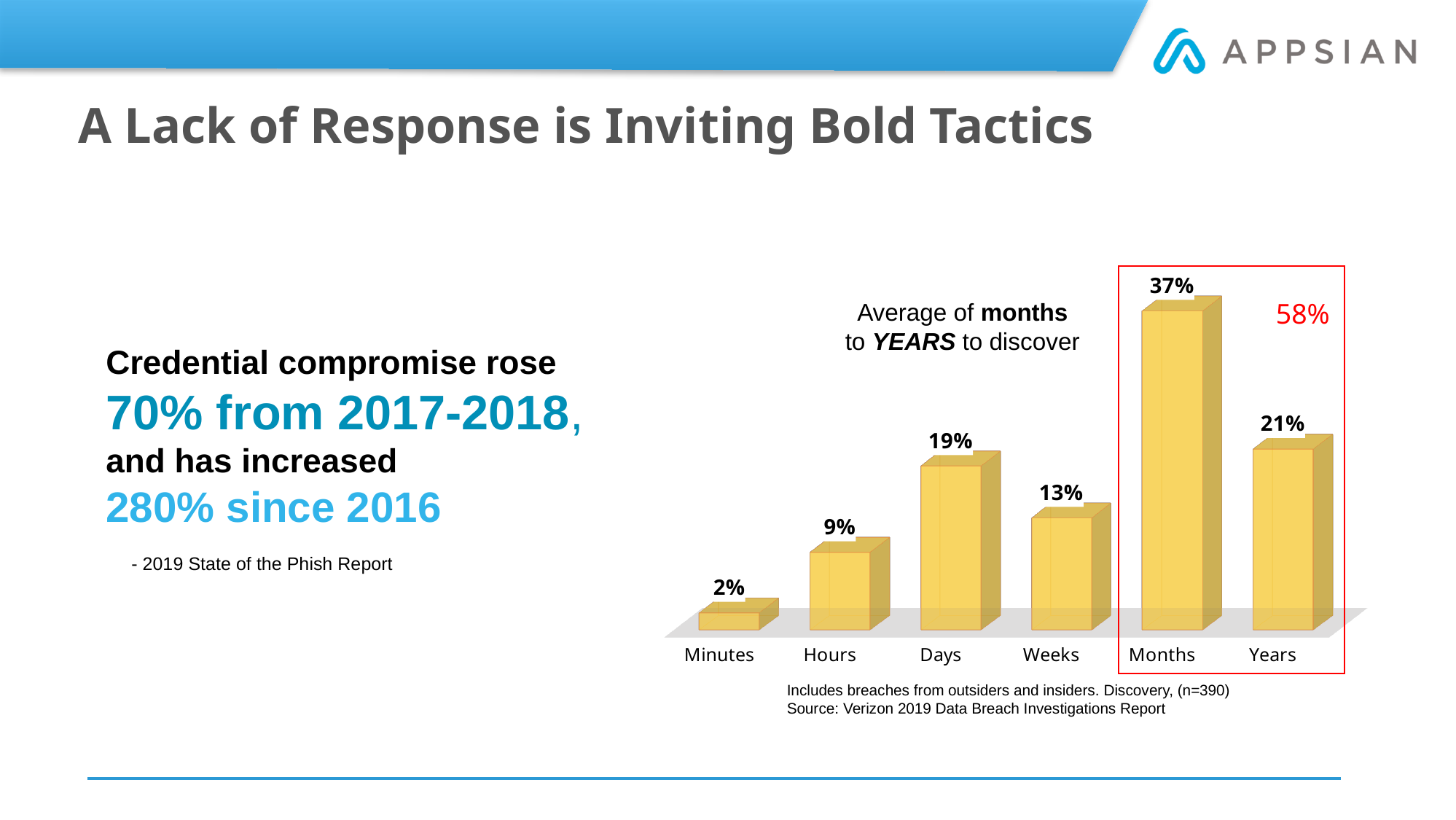
What is the combined value for Months and Years, as highlighted in the red box? 58% What is the value for Minutes? 2% What is the value for Weeks? 13% What is the difference between the values for Months and Years? 16% What kind of chart is shown on the slide? Bar chart Which category has the highest value? Months What is the source cited below the chart? Verizon 2019 Data Breach Investigations Report What is the value for Months? 37% What is the value for Days? 19% Which category has the lowest value? Minutes Which is larger, the value for Hours or the value for Weeks? Weeks How many categories are shown on the x axis? 6